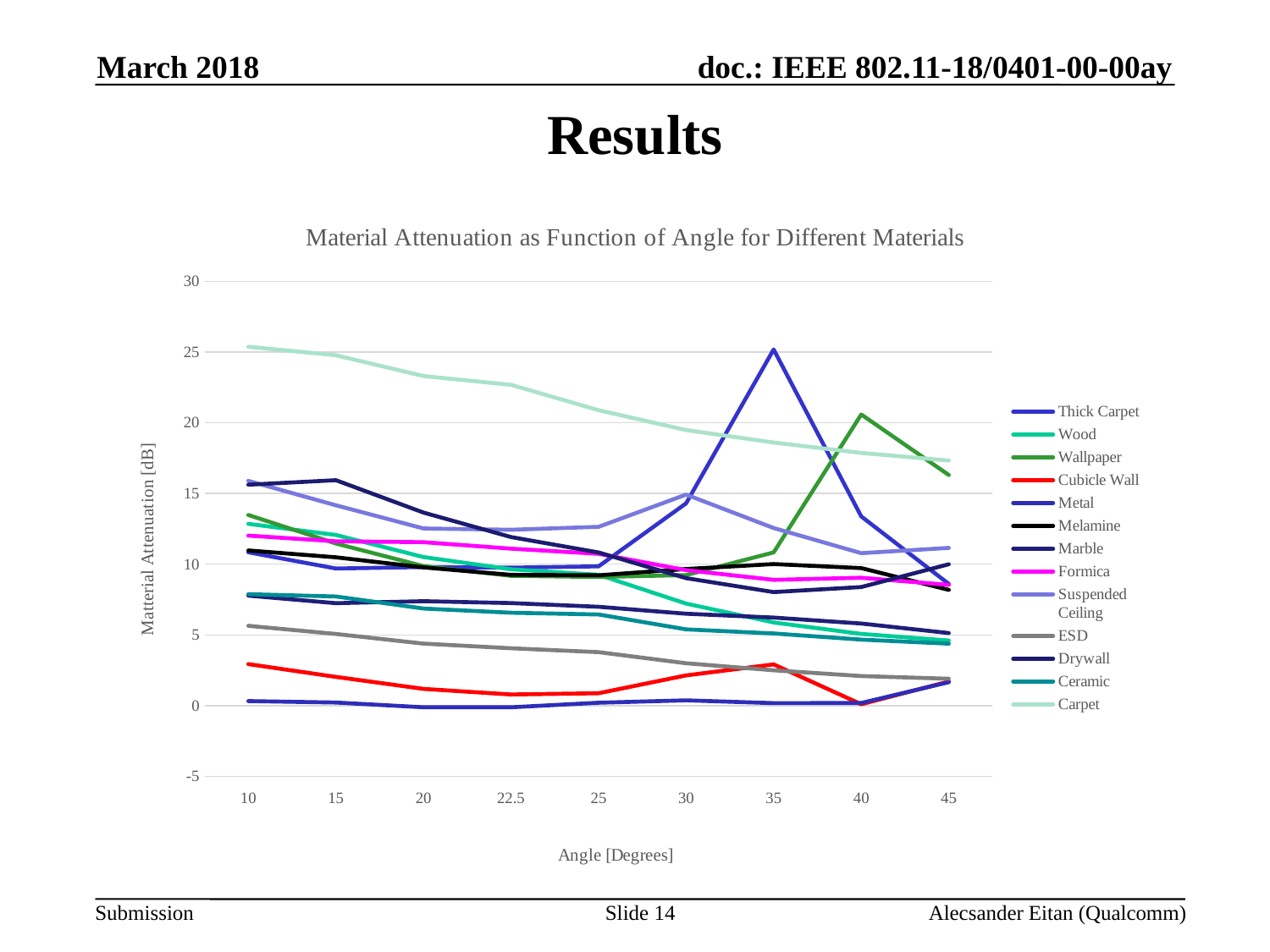
Is the value for Wallpaper at 40 degrees greater or less than 15? greater Is the value for Cubicle Wall at 10 degrees greater or less than 5? less At 40 degrees, which is larger: the value for Wallpaper or the value for Formica? Wallpaper What is the title of the chart? Material Attenuation as Function of Angle for Different Materials How many angle values are shown on the x axis? 9 Which material has the highest attenuation at 10 degrees? Carpet Which material has the highest attenuation at 40 degrees? Wallpaper Is the value for Carpet at 10 degrees greater or less than 20? greater Does the Carpet line rise or fall as the angle increases from 10 to 45 degrees? fall How many series does the legend list? 13 What kind of chart is shown on the slide? line chart What is the label of the y axis? Matterial Attenuation [dB]